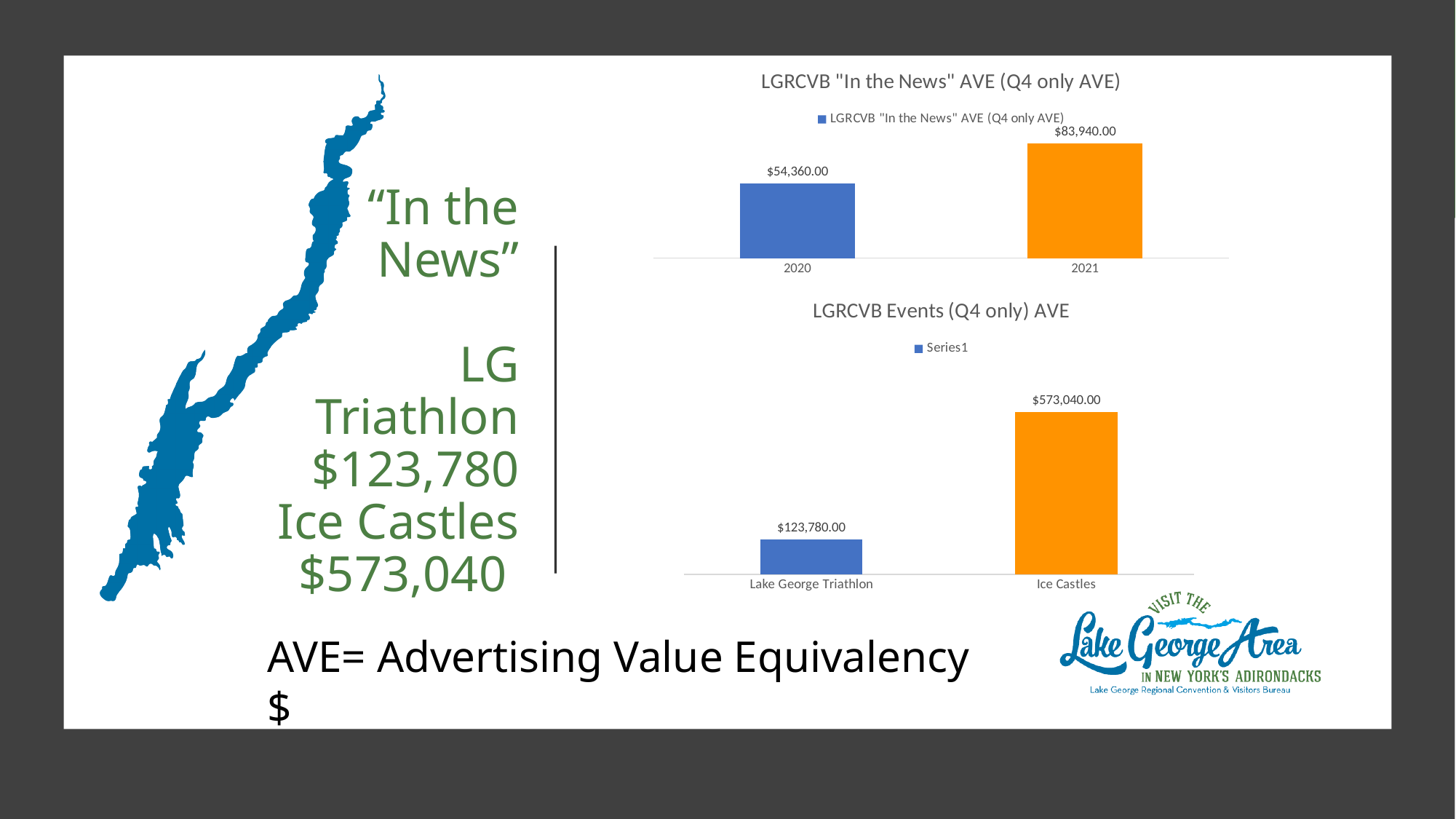
In the LGRCVB Events (Q4 only) AVE chart, what series name does the legend show? Series1 In the LGRCVB Events (Q4 only) AVE chart, what is the value for Lake George Triathlon? $123,780.00 In the LGRCVB Events (Q4 only) AVE chart, which category has the lowest value? Lake George Triathlon In the LGRCVB Events (Q4 only) AVE chart, what is the difference between the Ice Castles and Lake George Triathlon values? $449,260.00 In the LGRCVB "In the News" AVE (Q4 only AVE) chart, what is the value for 2020? $54,360.00 In the LGRCVB "In the News" AVE (Q4 only AVE) chart, which year has the higher value? 2021 In the LGRCVB "In the News" AVE (Q4 only AVE) chart, what is the difference between the 2021 and 2020 values? $29,580.00 In the LGRCVB Events (Q4 only) AVE chart, what is the value for Ice Castles? $573,040.00 In the LGRCVB "In the News" AVE (Q4 only AVE) chart, what is the value for 2021? $83,940.00 What kind of chart is the LGRCVB Events (Q4 only) AVE chart? bar chart In the LGRCVB "In the News" AVE (Q4 only AVE) chart, how many categories are shown? 2 In the LGRCVB "In the News" AVE (Q4 only AVE) chart, do the values rise or fall from 2020 to 2021? rise